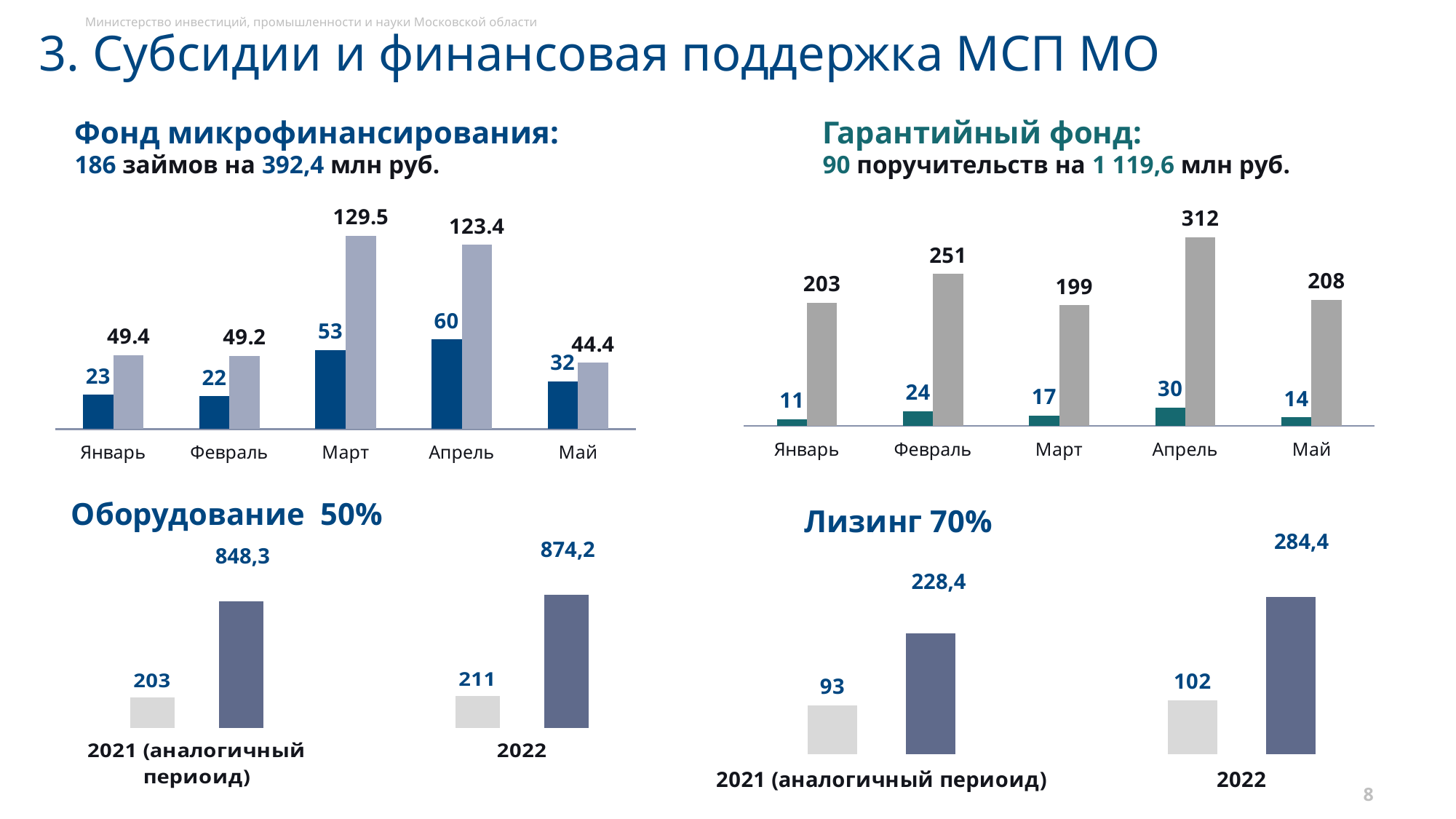
In the 'Лизинг 70%' chart, what is the difference between the dark bar values for 2022 and 2021 (аналогичный периоид)? 56,0 In the 'Гарантийный фонд' chart, what is the value of the grey bar for Апрель? 312 In the 'Фонд микрофинансирования' chart, which month has the lowest dark blue bar? Февраль In the 'Гарантийный фонд' chart, which month has the highest teal bar? Апрель In the 'Гарантийный фонд' chart, which is larger: the grey bar for Январь or the grey bar for Май? Май What kind of chart is the 'Оборудование 50%' chart? Bar chart In the 'Гарантийный фонд' chart, what is the difference between the grey bar values for Февраль and Март? 52 In the 'Фонд микрофинансирования' chart, what is the value of the light grey-blue bar for Март? 129.5 In the 'Оборудование 50%' chart, what is the value of the dark bar for 2022? 874,2 In the 'Фонд микрофинансирования' chart, what is the value of the dark blue bar for Апрель? 60 In the 'Фонд микрофинансирования' chart, how many months are shown on the x axis? 5 In the 'Лизинг 70%' chart, what is the value of the light grey bar for 2021 (аналогичный периоид)? 93